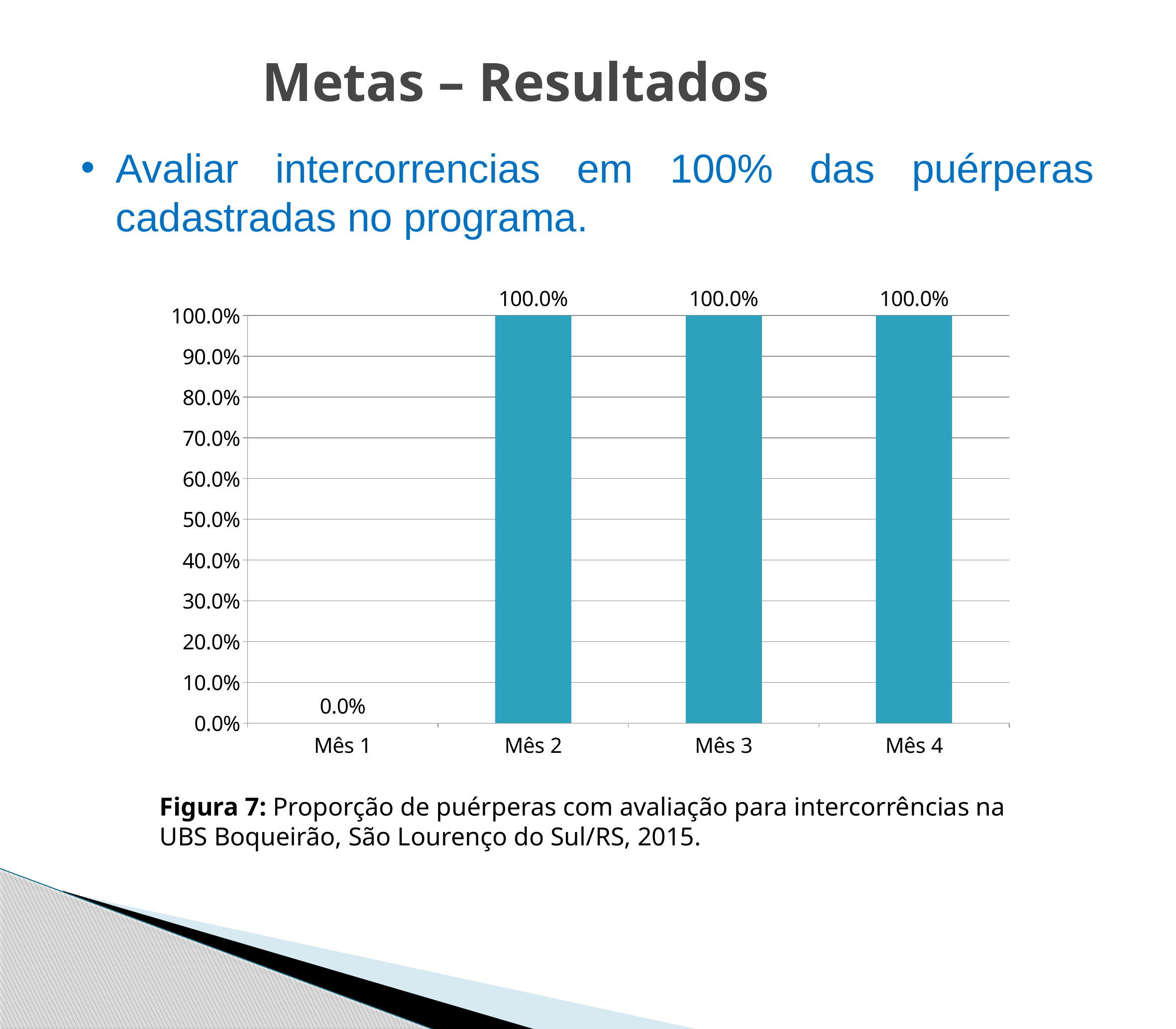
Is the value for Mês 4 greater or less than 50.0%? greater What is the value for Mês 4? 100.0% Do the values rise or fall from Mês 1 to Mês 2? rise How many months are shown on the x axis? 4 What is the value for Mês 1? 0.0% What is the difference between the values for Mês 2 and Mês 1? 100.0% What is the value for Mês 3? 100.0% Which month has the lowest value? Mês 1 What kind of chart is shown on the slide? bar chart Which is larger, the value for Mês 1 or the value for Mês 3? Mês 3 What is the value for Mês 2? 100.0% What is the figure number given in the caption below the chart? Figura 7